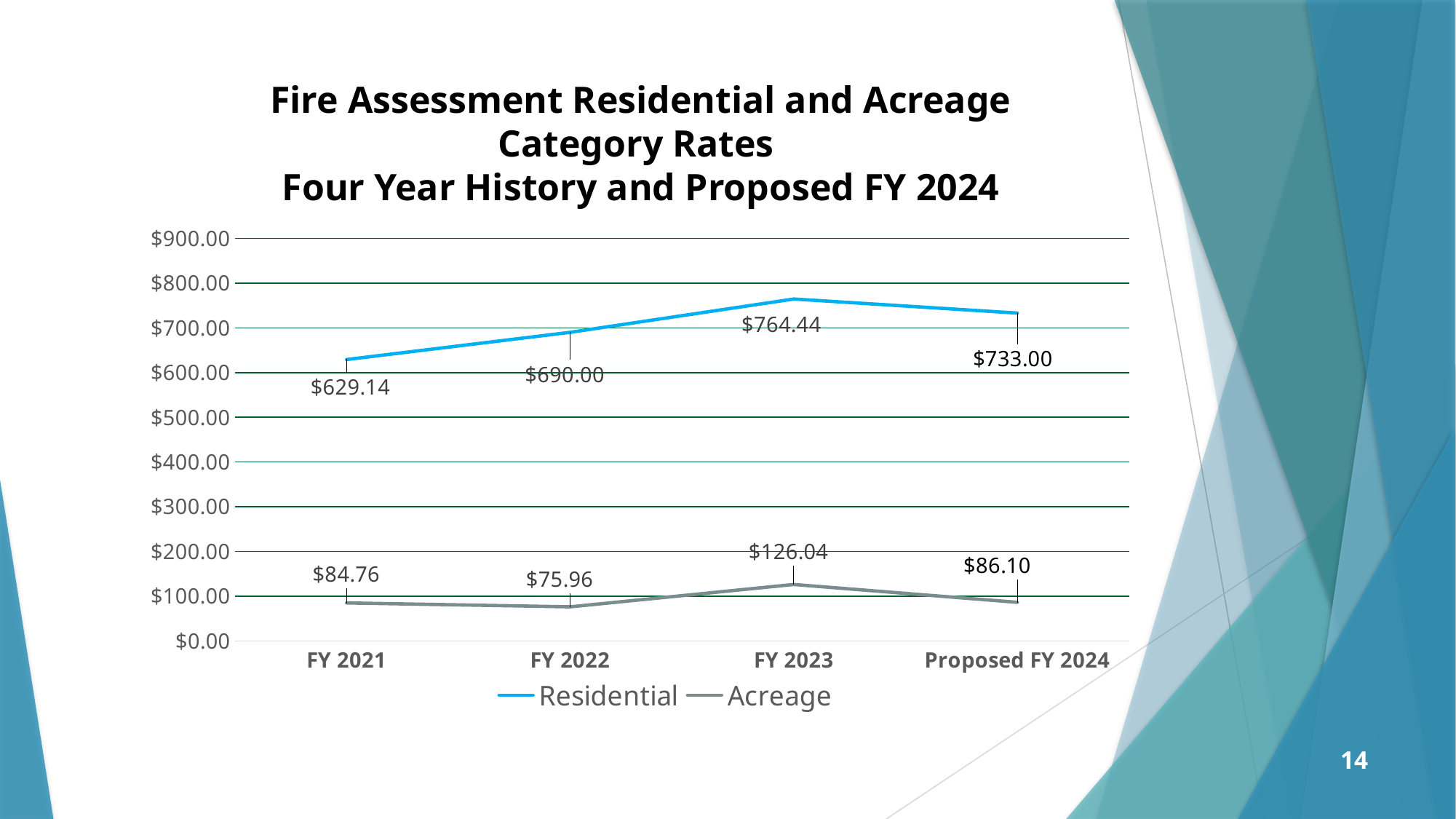
What is the proposed FY 2024 Residential rate? $733.00 In which fiscal year is the Residential rate lowest? FY 2021 What is the difference between the Residential rate in FY 2023 and the proposed FY 2024 Residential rate? $31.44 Is the Residential rate for FY 2022 greater or less than $600.00? greater How many fiscal year categories are shown on the x axis? 4 What is the Acreage rate for FY 2022? $75.96 Which is larger, the Acreage rate for FY 2021 or the Acreage rate for Proposed FY 2024? Proposed FY 2024 In which fiscal year is the Acreage rate highest? FY 2023 How many series does the legend list? 2 What kind of chart is shown on the slide? line chart Does the Residential rate rise or fall from FY 2021 to FY 2023? rise What is the Residential rate for FY 2023? $764.44